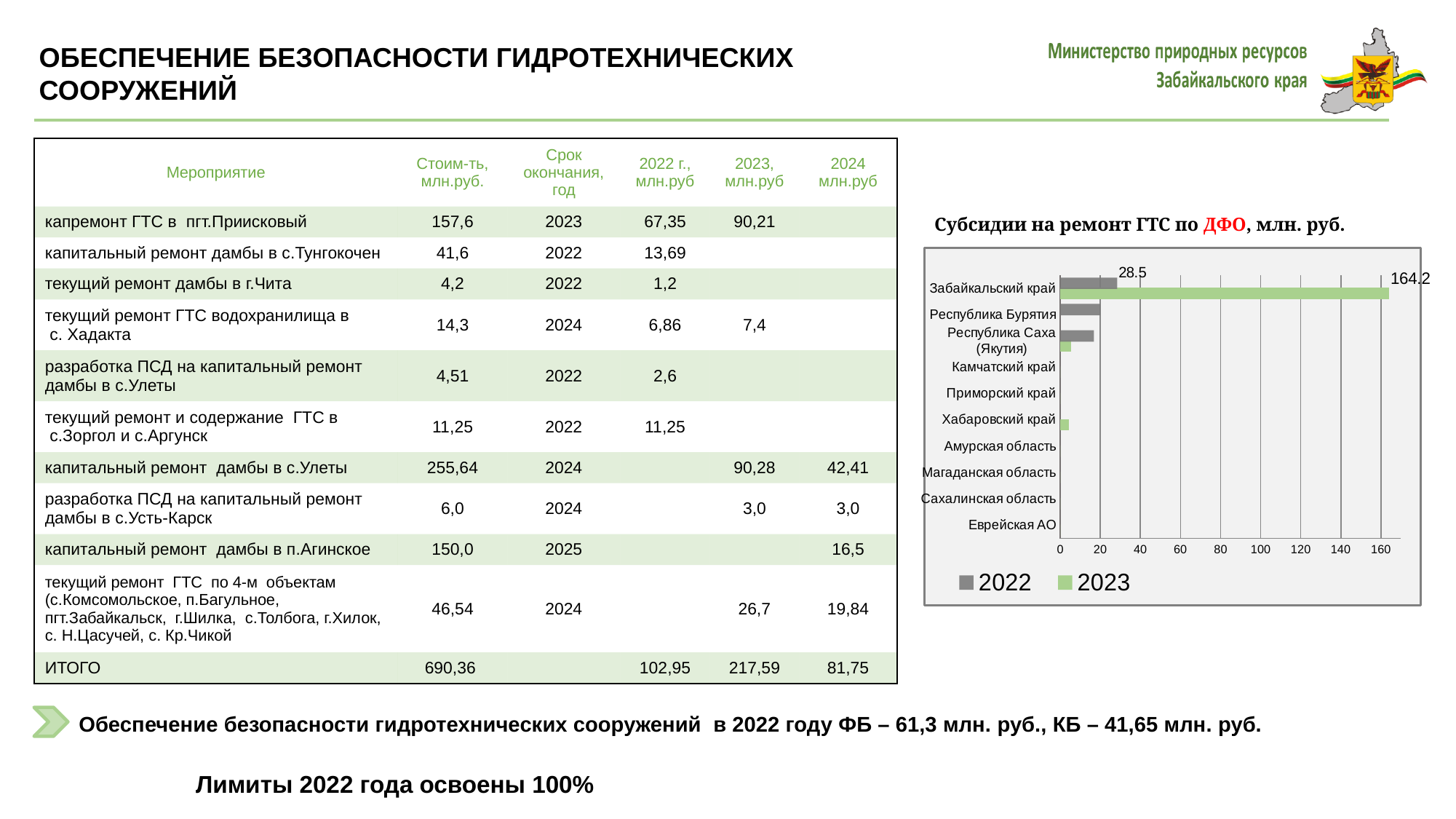
What kind of chart is shown on the slide? bar chart For Забайкальский край, which is larger: the 2022 value or the 2023 value? 2023 What are the two entries in the chart's legend? 2022 and 2023 Is the 2022 value for Республика Саха (Якутия) greater or less than 40? less What is the 2022 value for Забайкальский край in the chart? 28.5 How many regions are listed on the vertical axis of the chart? 10 How many series does the legend of the chart list? 2 What is the title of the chart? Субсидии на ремонт ГТС по ДФО, млн. руб. What is the difference between the 2023 and 2022 values for Забайкальский край? 135.7 Which region has the highest 2023 value in the chart? Забайкальский край Is the 2022 value for Республика Бурятия greater or less than 40? less What is the 2023 value for Забайкальский край in the chart? 164.2